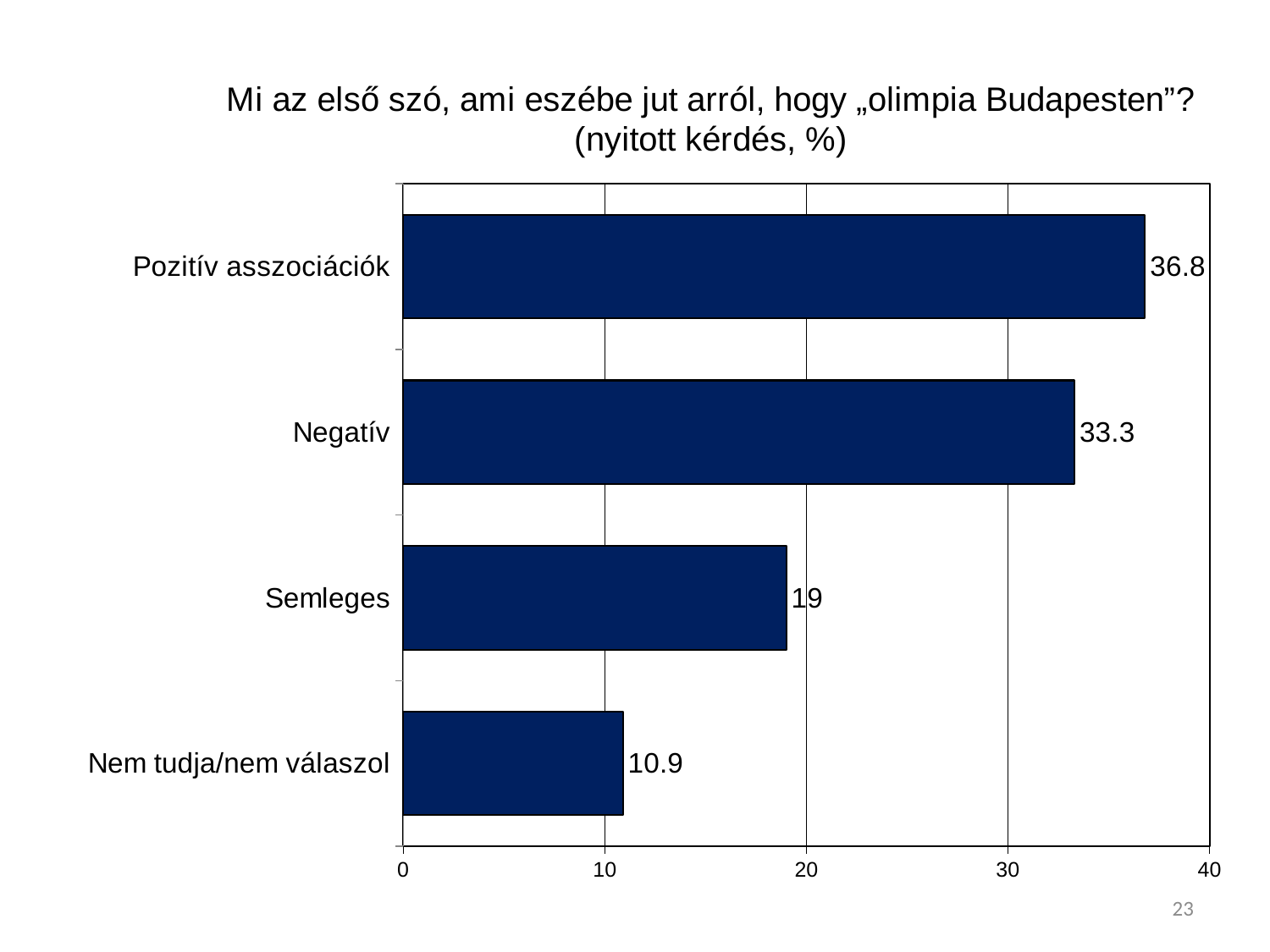
What is the difference between the values for Semleges and Nem tudja/nem válaszol? 8.1 What is the value for Pozitív asszociációk? 36.8 Which category has the lowest value? Nem tudja/nem válaszol What is the difference between the values for Pozitív asszociációk and Negatív? 3.5 What is the value for Semleges? 19 What is the value for Negatív? 33.3 What is the value for Nem tudja/nem válaszol? 10.9 Which is larger, the value for Negatív or the value for Semleges? Negatív Which category has the highest value? Pozitív asszociációk What kind of chart is shown on the slide? bar chart Is the value for Semleges greater or less than 20? less How many categories are shown in the chart? 4